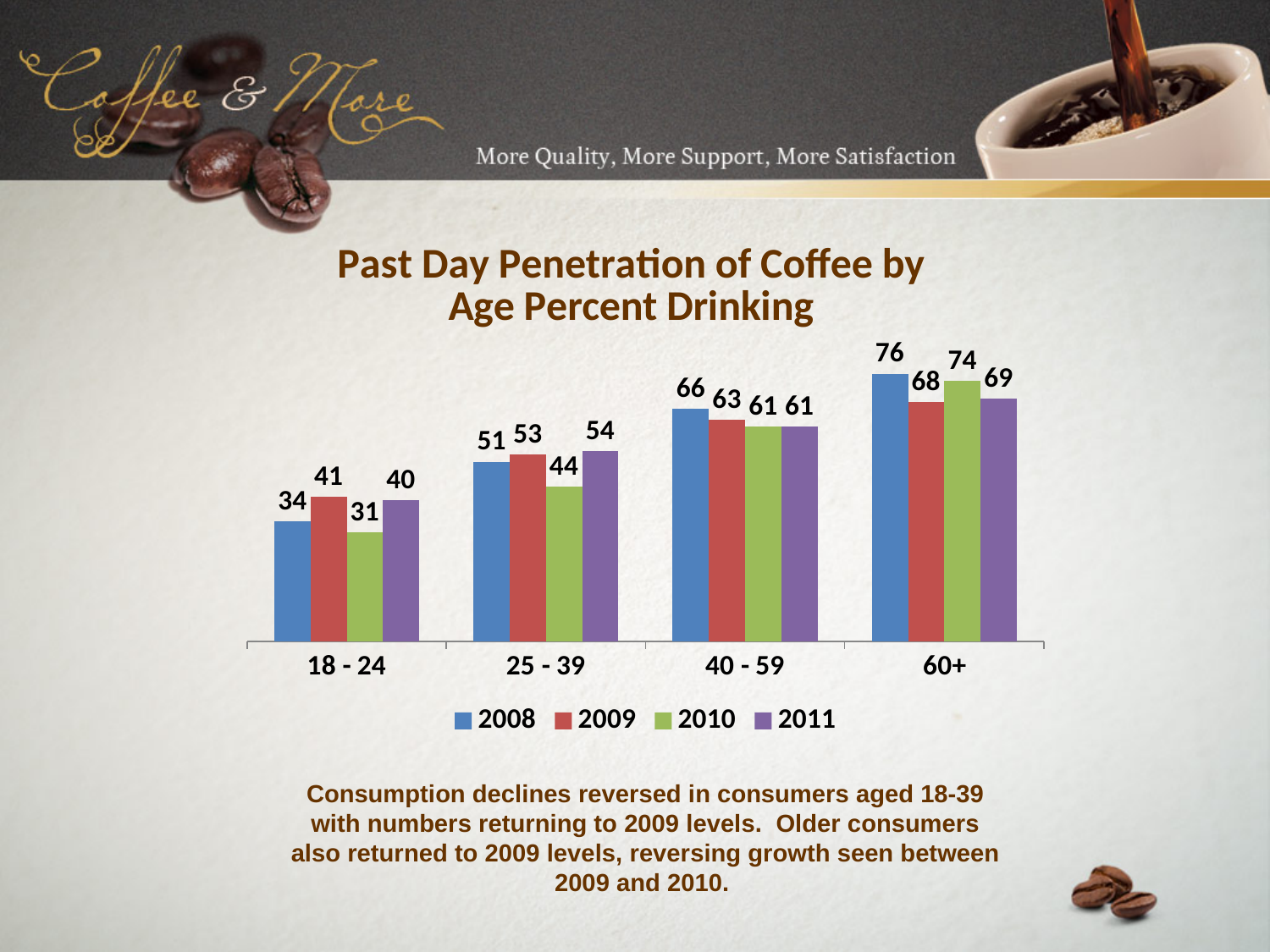
Do the values for the 2011 series rise or fall from the 18 - 24 group to the 60+ group? Rise What is the difference between the 2010 and 2011 values in the 25 - 39 age group? 10 Which age group has the lowest value for the 2010 series? 18 - 24 What is the value for the 2008 series in the 18 - 24 age group? 34 Which is larger in the 60+ age group, the 2009 value or the 2010 value? 2010 How many age groups are shown on the x axis? 4 What is the difference between the 2008 and 2009 values in the 18 - 24 age group? 7 Which age group has the highest value for the 2008 series? 60+ How many series does the legend list? 4 What is the value for the 2011 series in the 60+ age group? 69 What is the value for the 2010 series in the 25 - 39 age group? 44 What kind of chart is shown on the slide? Bar chart